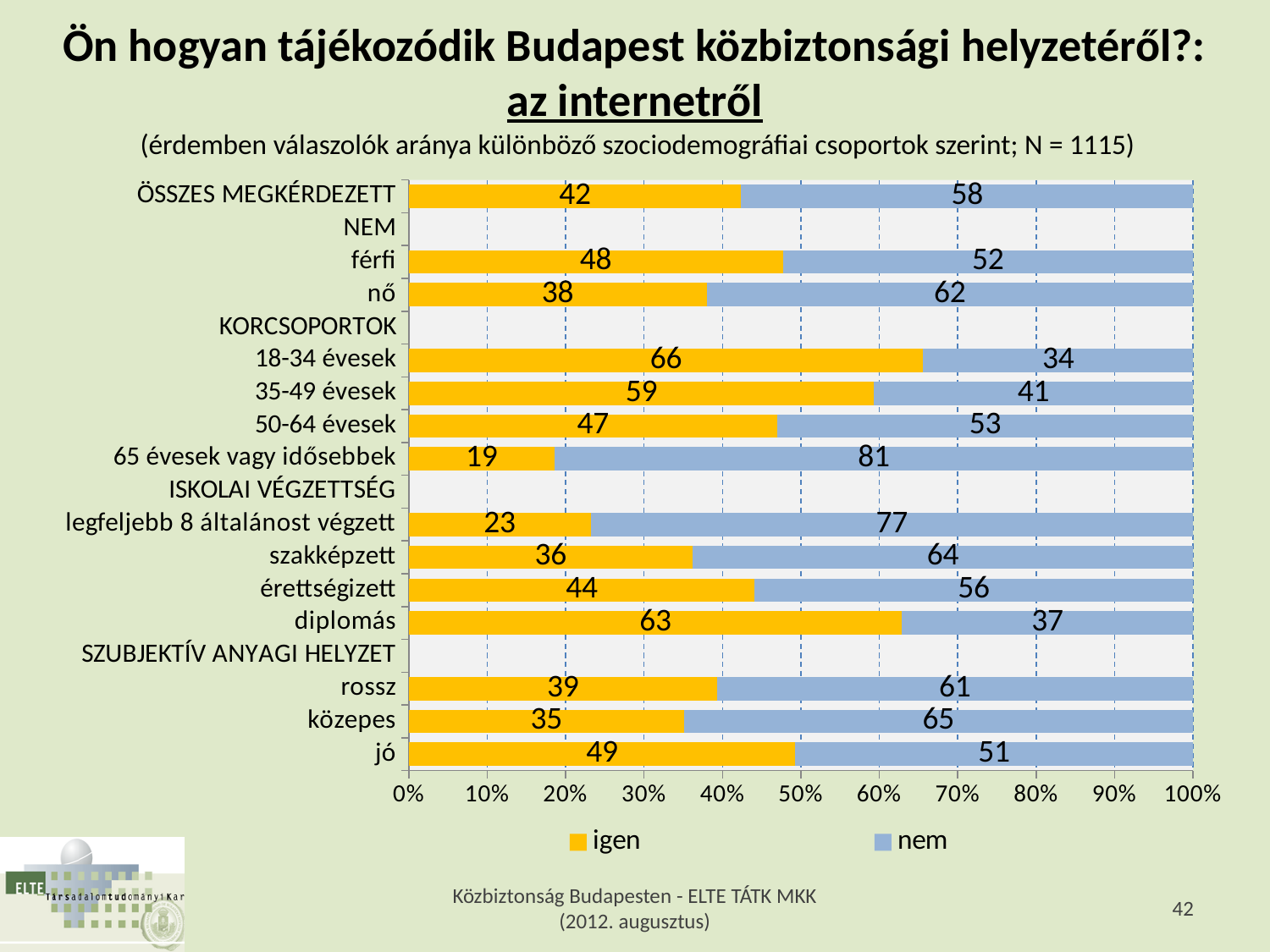
How many series does the legend list? 2 What is the difference between the 'igen' values for férfi and nő? 10 What is the total of the stacked bar for jó? 100 Which category has the lowest 'igen' value? 65 évesek vagy idősebbek Do the 'igen' values rise or fall going from 18-34 évesek down to 65 évesek vagy idősebbek? fall What is the 'igen' value for 18-34 évesek? 66 Which has a larger 'igen' value, diplomás or szakképzett? diplomás What is the 'nem' value for 65 évesek vagy idősebbek? 81 What is the 'igen' value for ÖSSZES MEGKÉRDEZETT? 42 Which colour represents the 'nem' series? blue What kind of chart is shown on the slide? stacked bar chart Which category has the highest 'igen' value? 18-34 évesek